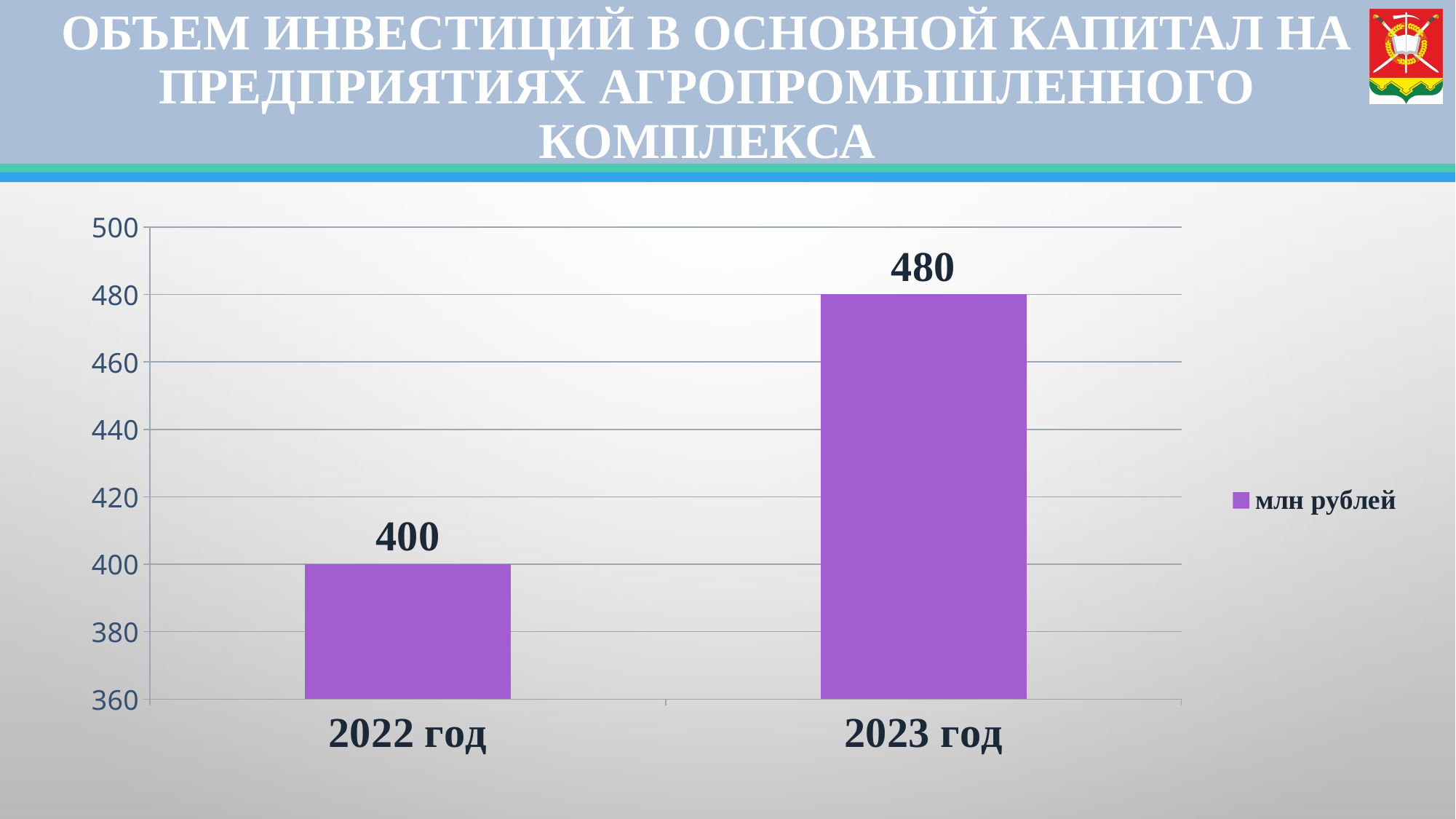
Which year has the lowest value? 2022 год Which is larger, the value for 2022 год or the value for 2023 год? 2023 год What is the value for 2022 год? 400 What is the value for 2023 год? 480 Which year has the highest value? 2023 год How many series does the legend list? 1 What is the difference between the values for 2023 год and 2022 год? 80 What kind of chart is shown on the slide? bar chart Do the values rise or fall from 2022 год to 2023 год? rise Is the value for 2023 год greater or less than 460? greater What is the legend entry for the series? млн рублей How many categories are shown on the x axis? 2